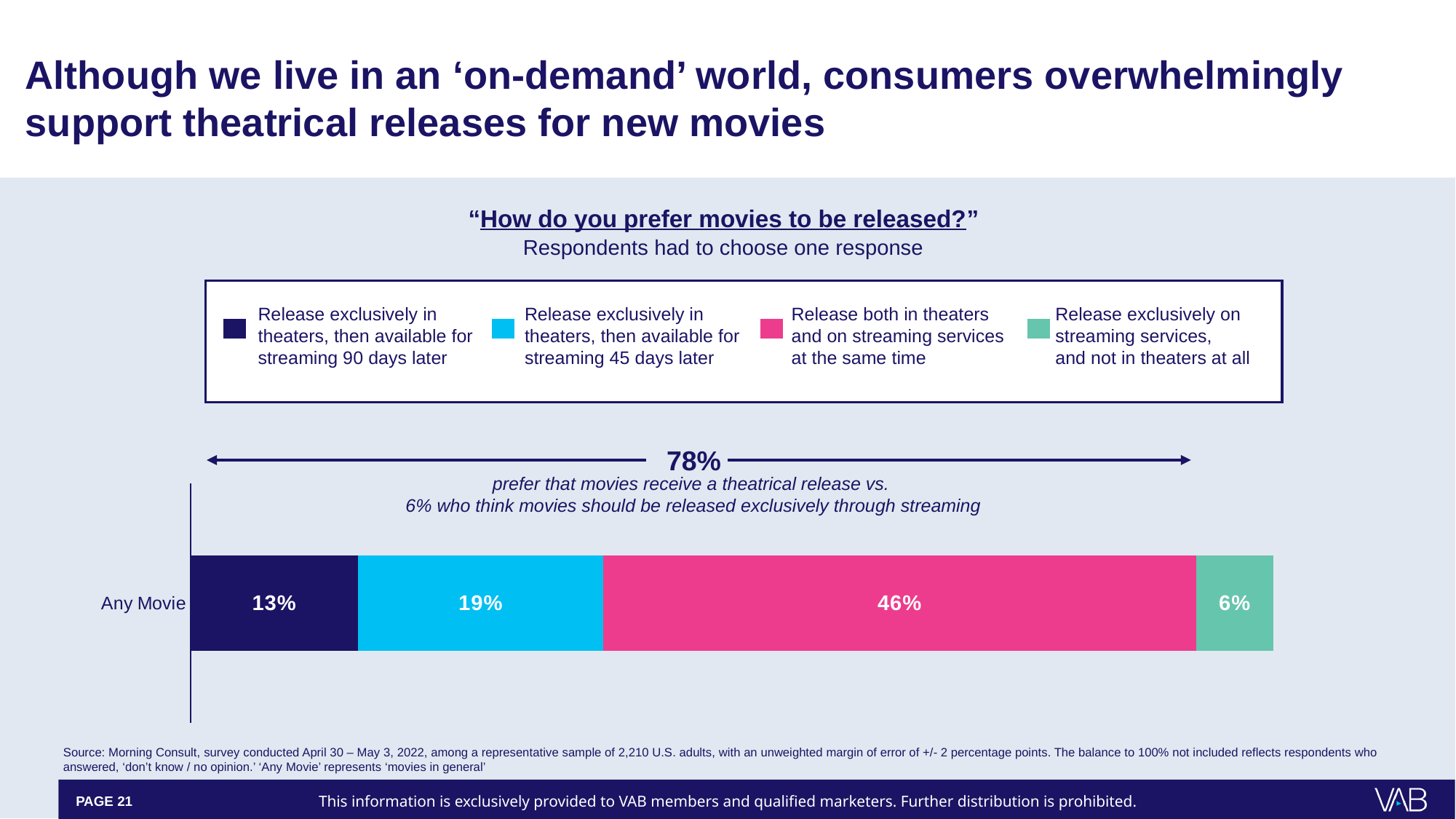
What percentage of respondents prefer movies to be released exclusively on streaming services, and not in theaters at all? 6% What percentage of respondents prefer movies to be released exclusively in theaters, then available for streaming 45 days later? 19% How many series does the legend list? 4 Which release option has the largest share of respondents? Release both in theaters and on streaming services at the same time Which release option has the smallest share of respondents? Release exclusively on streaming services, and not in theaters at all What kind of chart is shown on the slide? Stacked bar chart What percentage of respondents prefer movies to be released exclusively in theaters, then available for streaming 90 days later? 13% What is the difference in percentage points between respondents preferring release both in theaters and on streaming at the same time and those preferring exclusive theatrical release with streaming 45 days later? 27 percentage points What is the total of the four segments shown in the 'Any Movie' stacked bar? 84% Which is larger: the share preferring theatrical release with streaming 90 days later, or the share preferring theatrical release with streaming 45 days later? Theatrical release with streaming 45 days later What percentage of respondents prefer movies to be released both in theaters and on streaming services at the same time? 46% What is the label of the single category shown on the bar chart? Any Movie